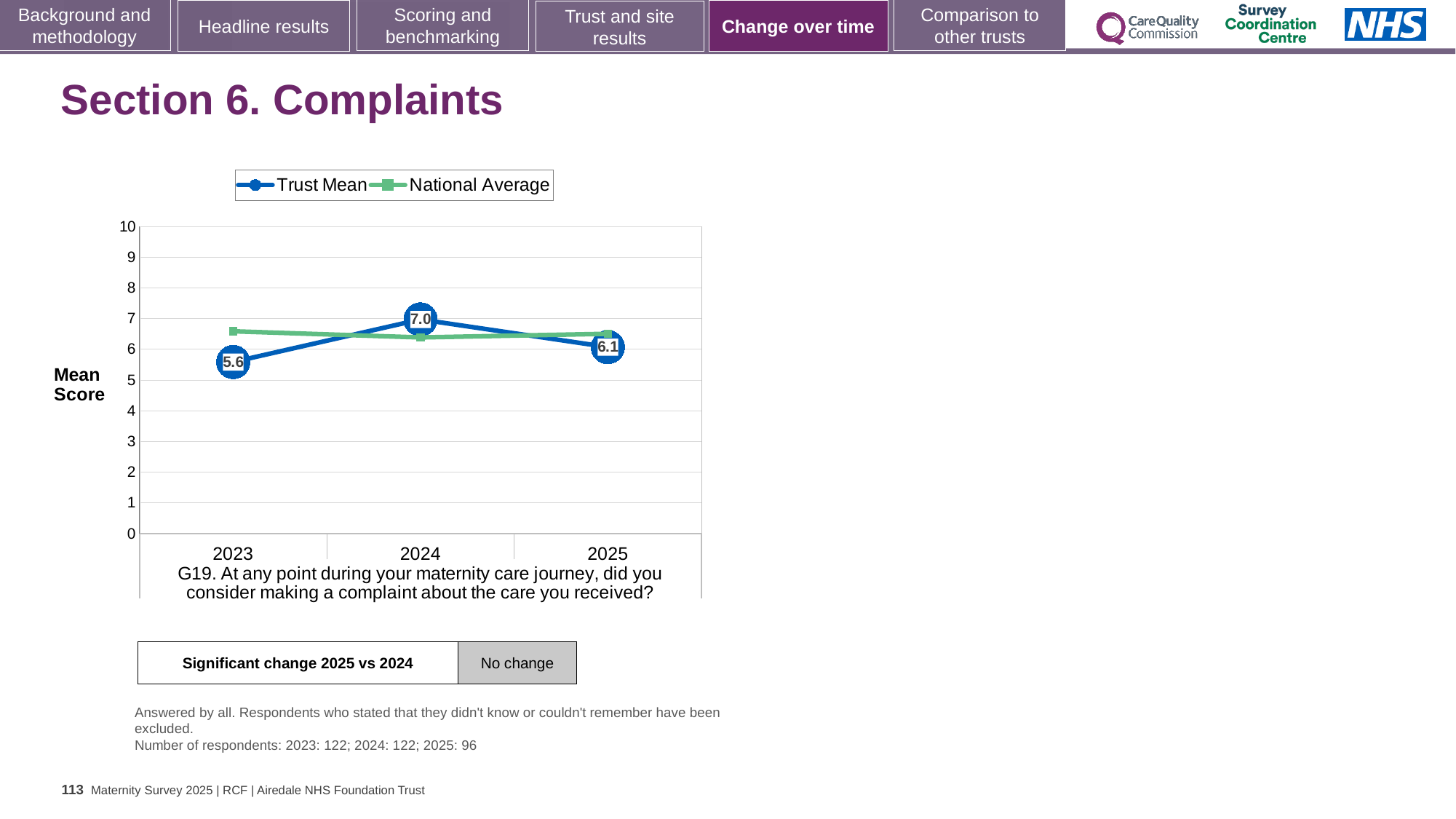
How many years are plotted on the x axis? 3 In which year is the Trust Mean highest? 2024 In which year is the Trust Mean lowest? 2023 What is the Trust Mean value for 2025? 6.1 What is the Trust Mean value for 2024? 7.0 What kind of chart is shown on the slide? Line chart Is the National Average value for 2023 greater or less than 6? greater How many series does the legend list? 2 Which is larger in 2023: the Trust Mean or the National Average? National Average Which is larger in 2024: the Trust Mean or the National Average? Trust Mean What is the Trust Mean value for 2023? 5.6 What is the difference between the Trust Mean in 2024 and in 2023? 1.4